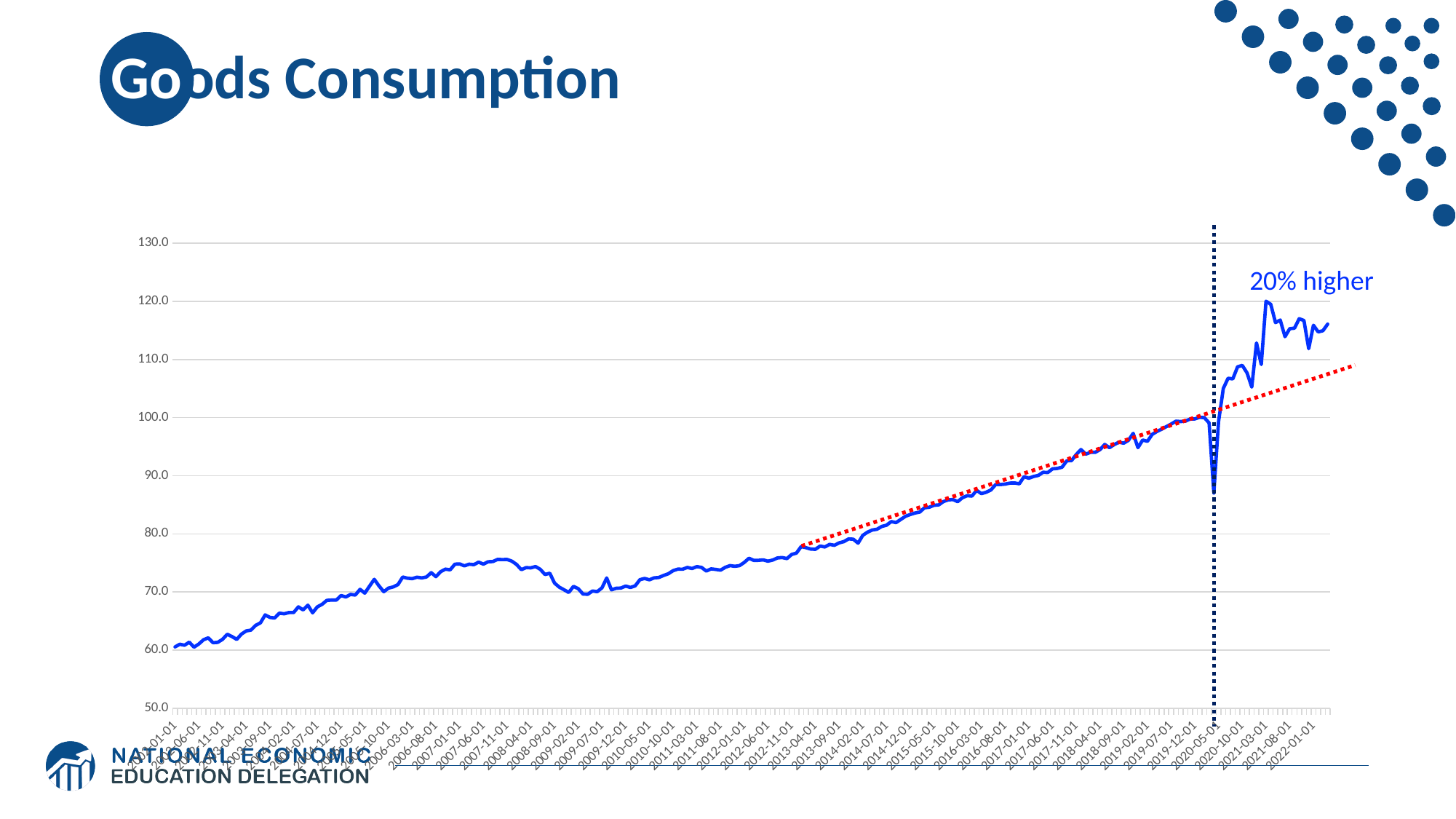
Is the value at 2013-04-01 greater or less than 80? less Does the line rise or fall between 2008-04-01 and 2009-02-01? fall Overall, does the plotted line rise or fall from 2005-01-01 to 2022-01-01? rise Is the value at 2015-05-01 greater or less than 80? greater Is the value at 2008-04-01 greater or less than 70? greater What is the highest value shown on the y axis? 130.0 What annotation text is written near the end of the line at the top right of the chart? 20% higher What is the title of the chart? Goods Consumption What kind of chart is shown on the slide? line chart